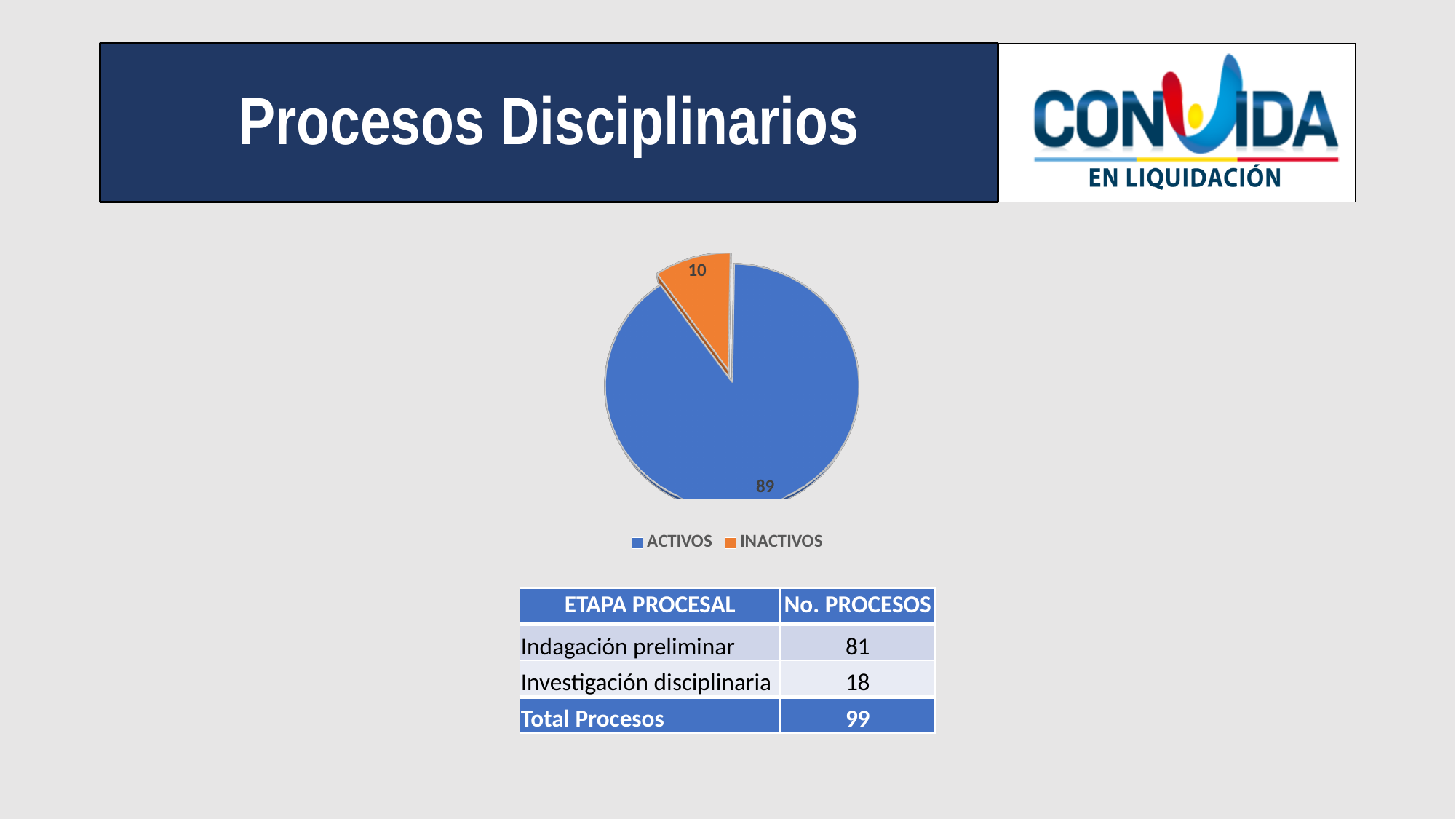
What share of the pie chart's total does the INACTIVOS slice represent? 10 out of 99 What is the value of the INACTIVOS slice in the pie chart? 10 What is the value of the ACTIVOS slice in the pie chart? 89 What is the difference between the ACTIVOS and INACTIVOS values in the pie chart? 79 What is the total of the two slices in the pie chart? 99 Which is larger in the pie chart, ACTIVOS or INACTIVOS? ACTIVOS Which category has the smallest slice in the pie chart? INACTIVOS What kind of chart is shown on the slide? Pie chart How many entries does the pie chart's legend list? 2 How many slices does the pie chart have? 2 Which category has the largest slice in the pie chart? ACTIVOS What colour is the INACTIVOS slice in the pie chart? Orange